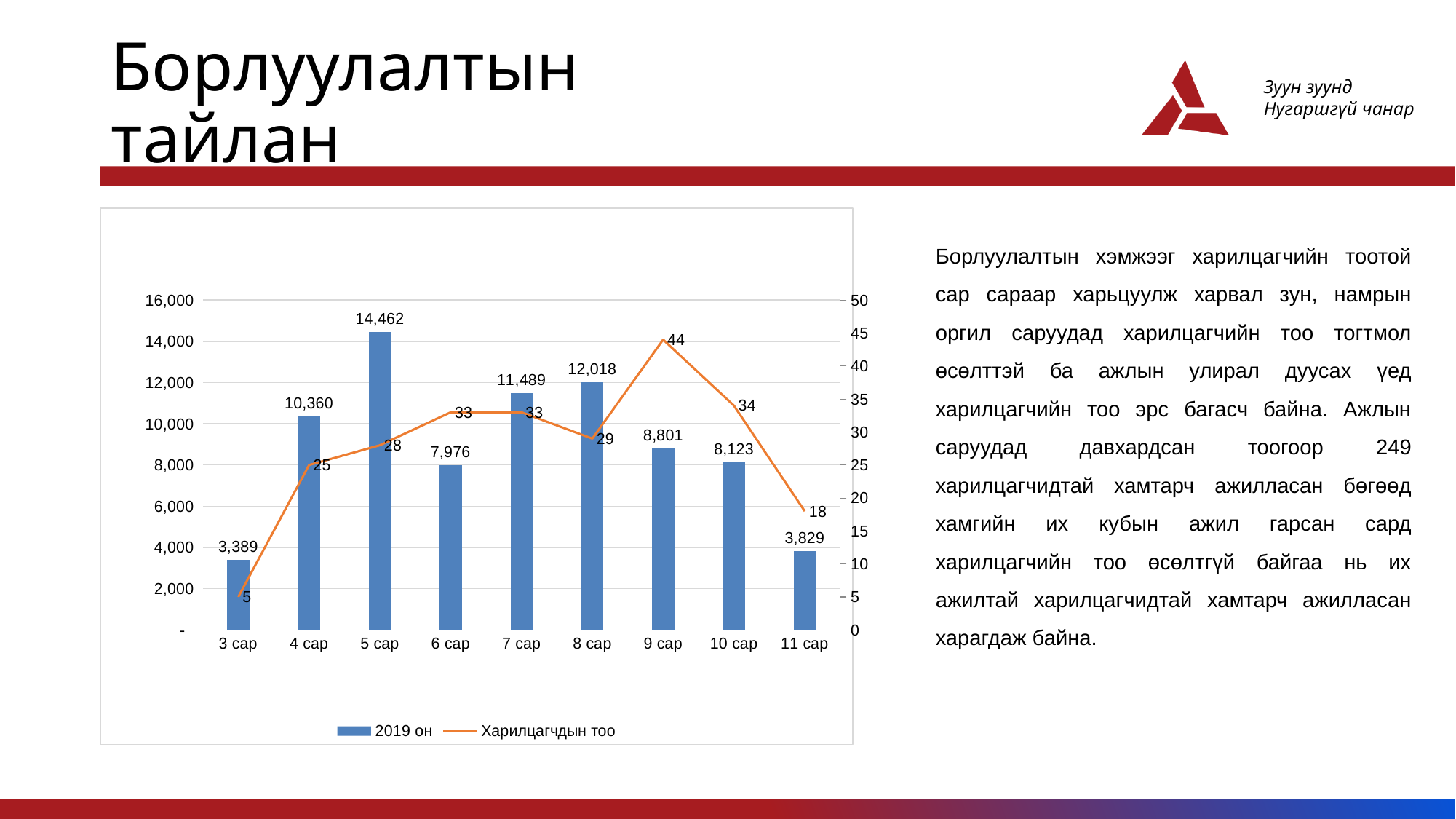
How many series does the legend list? 2 What is the value of the 2019 он bar for 5 сар? 14,462 Does the Харилцагчдын тоо line rise or fall from 9 сар to 11 сар? fall Which is larger, the 2019 он bar for 9 сар or for 10 сар? 9 сар Which month has the lowest Харилцагчдын тоо value? 3 сар What is the difference between the 2019 он values for 8 сар and 7 сар? 529 Which month has the lowest 2019 он bar? 3 сар How many months are shown on the x axis? 9 What is the value of the 2019 он bar for 11 сар? 3,829 What is the Харилцагчдын тоо value for 9 сар? 44 Which month has the highest 2019 он bar? 5 сар What is the difference between the Харилцагчдын тоо values for 9 сар and 10 сар? 10